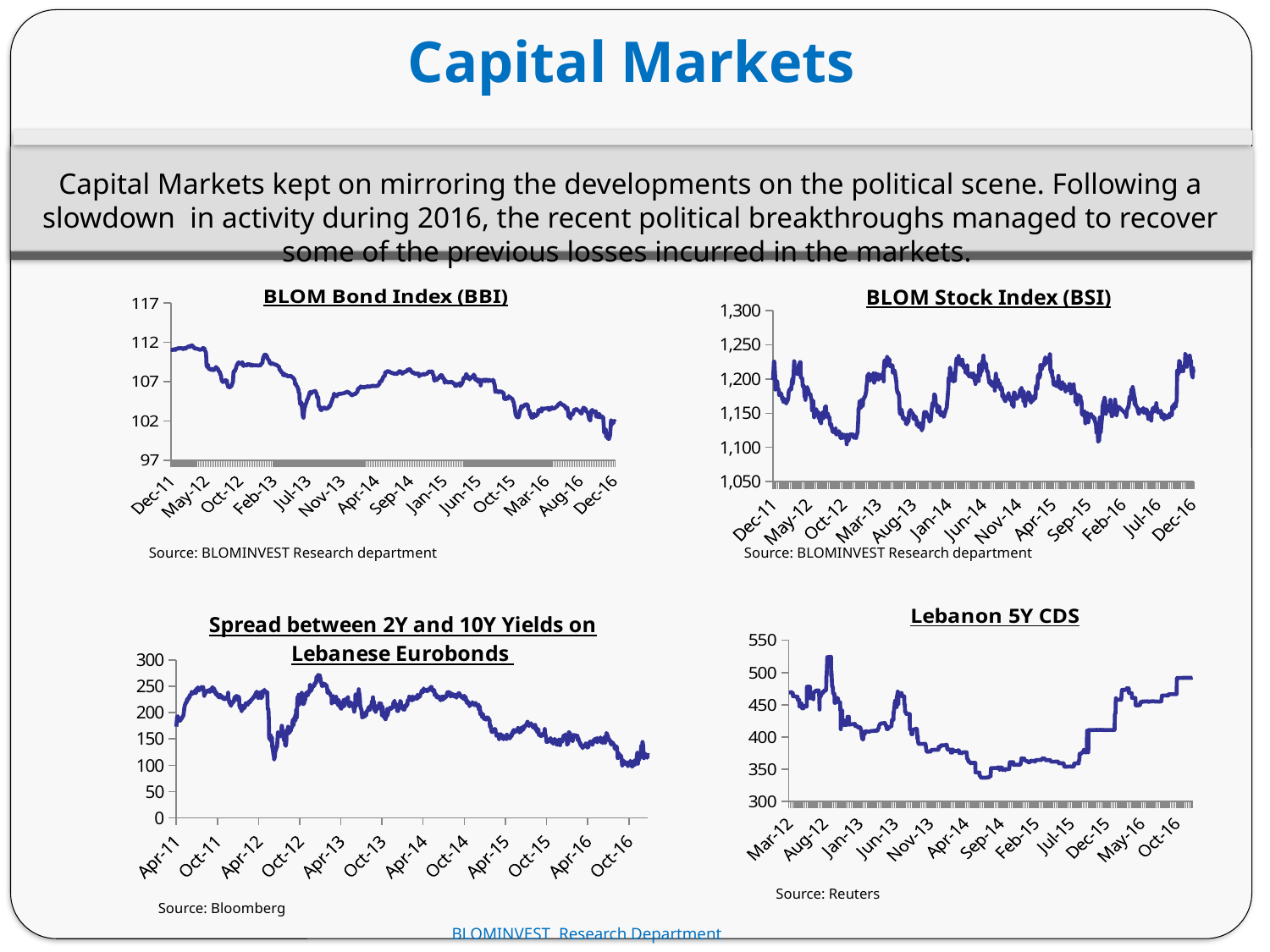
In the BLOM Stock Index (BSI) chart, is the value at Oct-12 greater or less than 1,150? less In the Lebanon 5Y CDS chart, is the value at Sep-14 greater or less than 400? less In the Lebanon 5Y CDS chart, does the value rise or fall between Dec-15 and Oct-16? rise In the BLOM Bond Index (BBI) chart, is the value at Dec-11 greater or less than 107? greater What kind of chart is the BLOM Bond Index (BBI) chart? line chart What source is cited below the Lebanon 5Y CDS chart? Reuters In the BLOM Bond Index (BBI) chart, does the index overall rise or fall from Dec-11 to Dec-16? fall In the Spread between 2Y and 10Y Yields on Lebanese Eurobonds chart, does the spread overall rise or fall from Apr-11 to Oct-16? fall